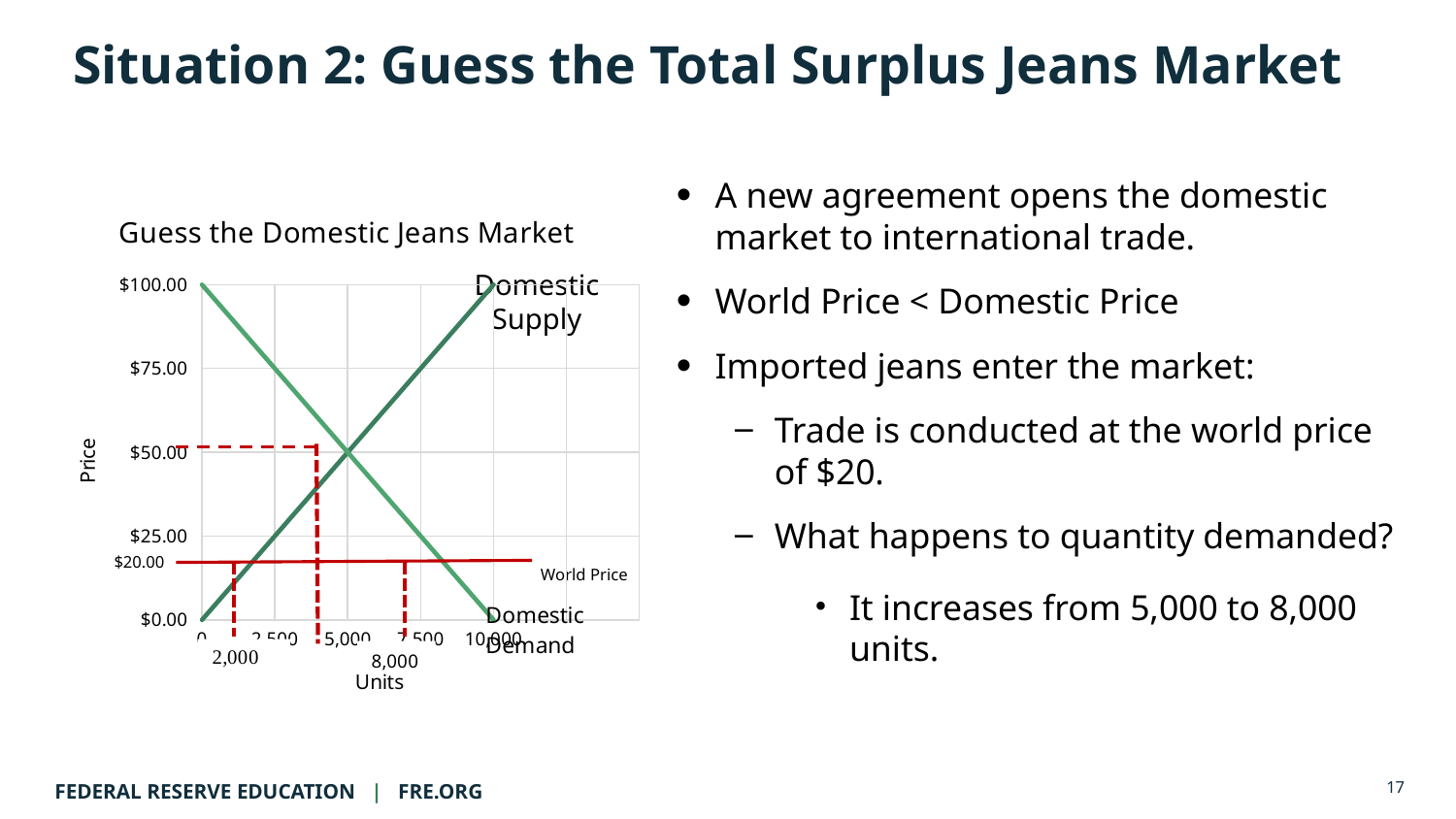
At what quantity (in units) do the Domestic Supply and Domestic Demand lines intersect? 5,000 What is the label on the vertical axis of the chart? Price At the World Price, what quantity is supplied domestically according to the dashed line on the chart? 2,000 What is the difference between the quantity demanded (8,000) and the quantity supplied (2,000) at the World Price? 6,000 What type of chart is shown on the slide? line chart At the World Price, what quantity is demanded according to the dashed line on the chart? 8,000 What is the title of the chart on the slide? Guess the Domestic Jeans Market Which is higher, the domestic equilibrium price or the World Price? the domestic equilibrium price At what price do the Domestic Supply and Domestic Demand lines intersect? $50.00 Is the World Price greater or less than $25.00? less What is the World Price shown on the chart? $20.00 Does the Domestic Demand line rise or fall as Units increase? fall